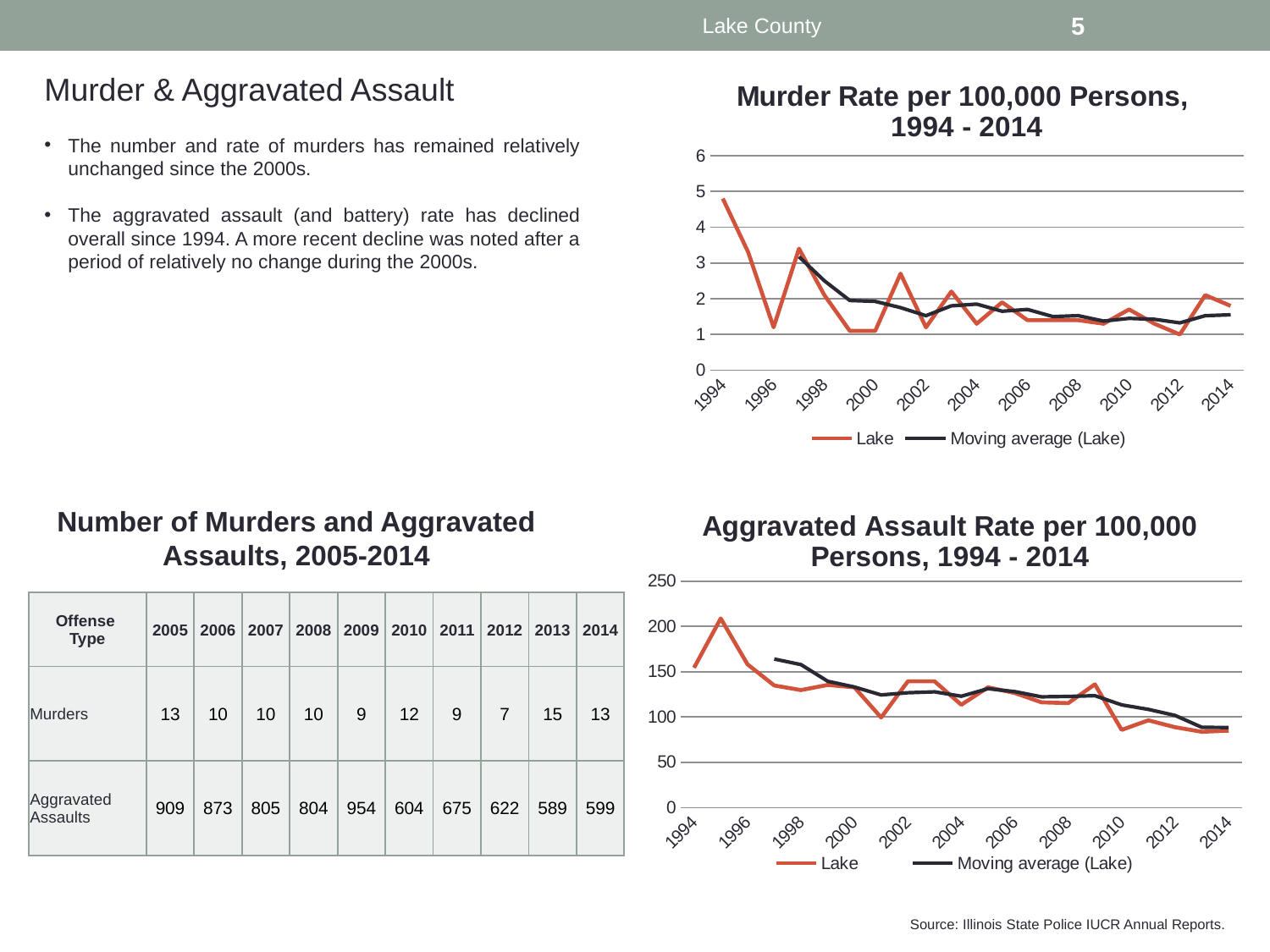
What kind of chart is the 'Murder Rate per 100,000 Persons, 1994 - 2014' chart? line chart In the 'Murder Rate per 100,000 Persons, 1994 - 2014' chart, does the Lake murder rate overall rise or fall from 1994 to 2014? fall In the 'Aggravated Assault Rate per 100,000 Persons, 1994 - 2014' chart, is the Lake value for 2010 greater or less than 100? less What are the two legend entries in the 'Aggravated Assault Rate per 100,000 Persons, 1994 - 2014' chart? Lake; Moving average (Lake) In the 'Aggravated Assault Rate per 100,000 Persons, 1994 - 2014' chart, which year has the highest Lake aggravated assault rate? 1995 In the 'Aggravated Assault Rate per 100,000 Persons, 1994 - 2014' chart, is the Lake value for 1995 greater or less than 200? greater In the 'Murder Rate per 100,000 Persons, 1994 - 2014' chart, which year has the highest Lake murder rate? 1994 What kind of chart is the 'Aggravated Assault Rate per 100,000 Persons, 1994 - 2014' chart? line chart In the 'Murder Rate per 100,000 Persons, 1994 - 2014' chart, is the Lake value for 1996 greater or less than 2? less How many series does the legend of the 'Murder Rate per 100,000 Persons, 1994 - 2014' chart list? 2 In the 'Aggravated Assault Rate per 100,000 Persons, 1994 - 2014' chart, does the Lake aggravated assault rate overall rise or fall from 1994 to 2014? fall